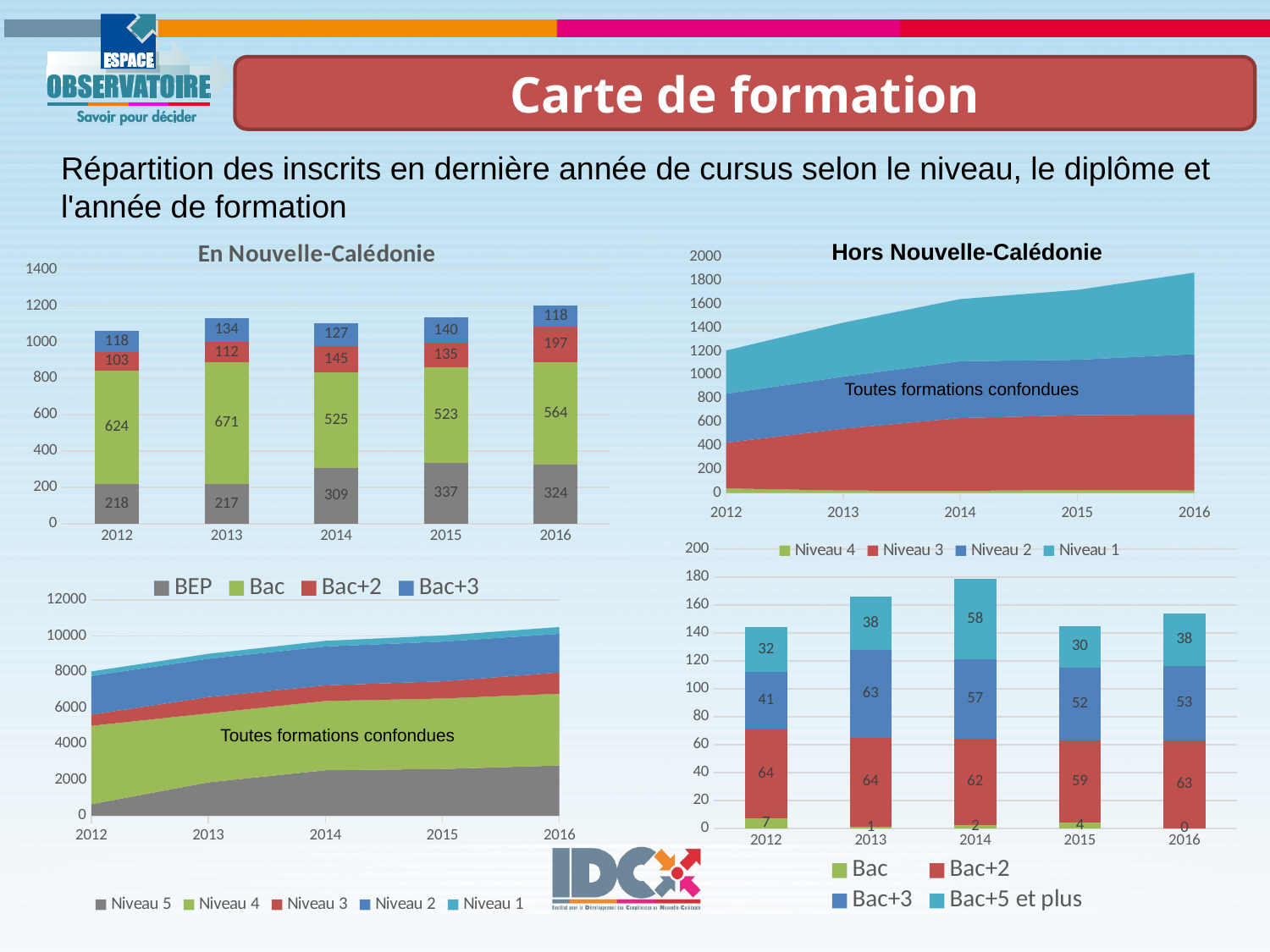
In the bottom-right stacked bar chart, how many years are shown on the x axis? 5 In the bottom-right stacked bar chart, which year has the lowest Bac value? 2016 In the 'En Nouvelle-Calédonie' chart, what is the value for Bac in 2013? 671 How many series does the legend of the bottom-left area chart list? 5 In the 'En Nouvelle-Calédonie' chart, which year has the highest Bac+2 value? 2016 What kind of chart is the 'Hors Nouvelle-Calédonie' chart at the top right? Area chart In the 'En Nouvelle-Calédonie' chart, what is the value for BEP in 2015? 337 In the bottom-right stacked bar chart, what is the value for 'Bac+5 et plus' in 2014? 58 In the bottom-right stacked bar chart, which is larger: the Bac+3 value for 2013 or for 2015? 2013 In the 'En Nouvelle-Calédonie' chart, what is the difference between the Bac values for 2013 and 2014? 146 In the 'En Nouvelle-Calédonie' chart, what is the total of the stacked bar for 2012? 1063 In the 'Hors Nouvelle-Calédonie' area chart, is the total value in 2016 greater or less than 1800? greater